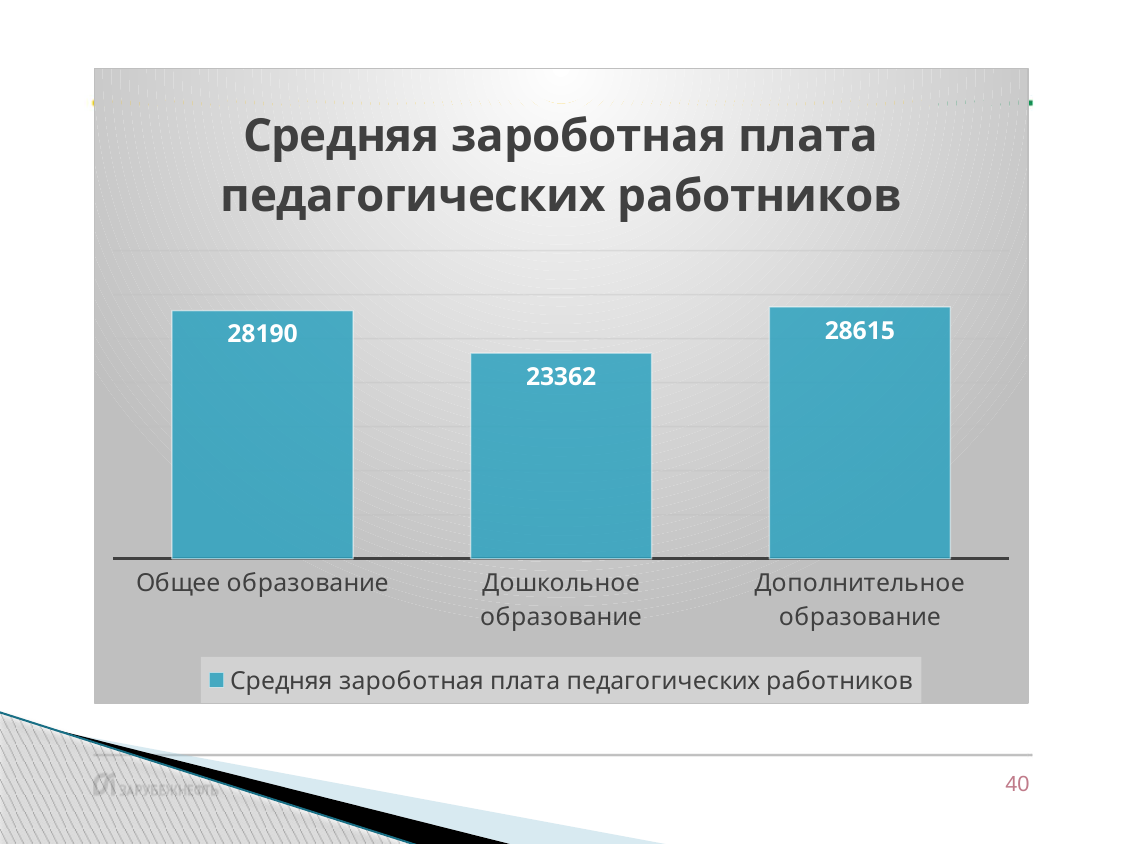
What is the value for Общее образование? 28190 Which category has the lowest value? Дошкольное образование What is the value for Дополнительное образование? 28615 How many categories are shown in the chart? 3 What is the difference between the values for Общее образование and Дошкольное образование? 4828 Which is larger, the value for Общее образование or the value for Дошкольное образование? Общее образование What kind of chart is shown on the slide? bar chart What is the title of the chart? Средняя зароботная плата педагогических работников Which category has the highest value? Дополнительное образование How many series does the legend list? 1 What is the value for Дошкольное образование? 23362 What is the difference between the values for Дополнительное образование and Дошкольное образование? 5253